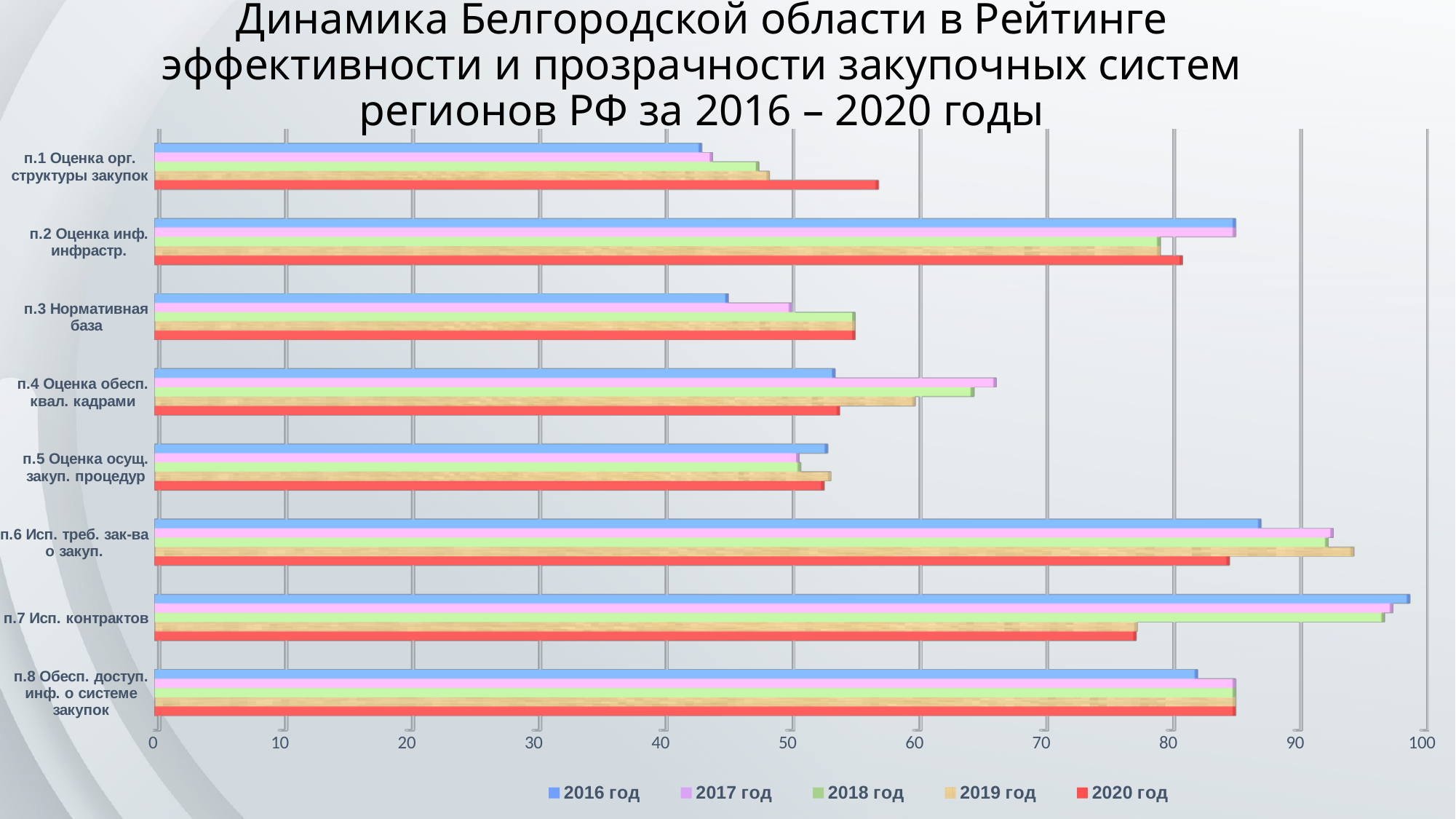
Which category has the highest value for 2019 год? п.6 Исп. треб. зак-ва о закуп. In category п.7 Исп. контрактов, which is larger: the value for 2016 год or for 2019 год? 2016 год Is the value for 2016 год in category п.3 Нормативная база greater or less than 50? less Is the value for 2016 год in category п.2 Оценка инф. инфрастр. greater or less than 80? greater What kind of chart is shown on the slide? bar chart How many categories (п.1 to п.8) are plotted on the chart? 8 Is the value for 2020 год in category п.1 Оценка орг. структуры закупок greater or less than 50? greater Which category has the highest value for 2016 год? п.7 Исп. контрактов In category п.4 Оценка обесп. квал. кадрами, which is larger: the value for 2017 год or for 2020 год? 2017 год How many series does the legend list? 5 Which colour represents 2020 год in the legend? red